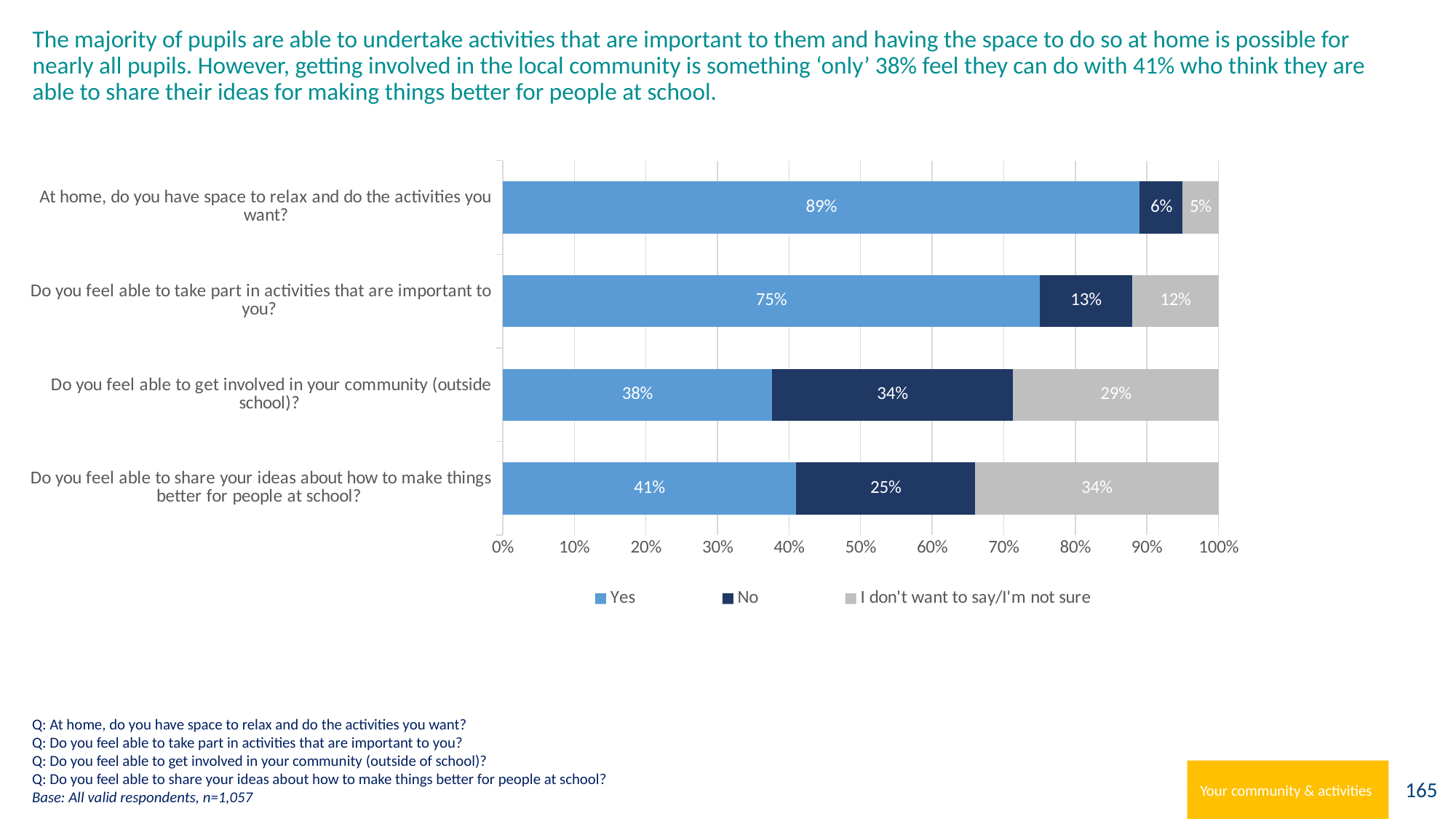
Which question has the highest 'Yes' percentage? At home, do you have space to relax and do the activities you want? What percentage answered 'I don't want to say/I'm not sure' to 'Do you feel able to get involved in your community (outside school)?' 29% What percentage of pupils answered 'Yes' to 'At home, do you have space to relax and do the activities you want?' 89% How many questions (categories) are shown in the chart? 4 Which question has the lowest 'Yes' percentage? Do you feel able to get involved in your community (outside school)? How many series does the legend list? 3 What is the difference between the 'Yes' percentage for taking part in important activities and the 'Yes' percentage for getting involved in the community? 37% Which colour represents the 'No' responses in the chart? Dark blue What percentage answered 'No' to 'Do you feel able to take part in activities that are important to you?' 13% Which is larger: the 'No' percentage for getting involved in the community or the 'No' percentage for sharing ideas at school? Getting involved in the community (34%) What kind of chart is shown on the slide? Stacked bar chart What percentage answered 'Yes' to 'Do you feel able to share your ideas about how to make things better for people at school?' 41%